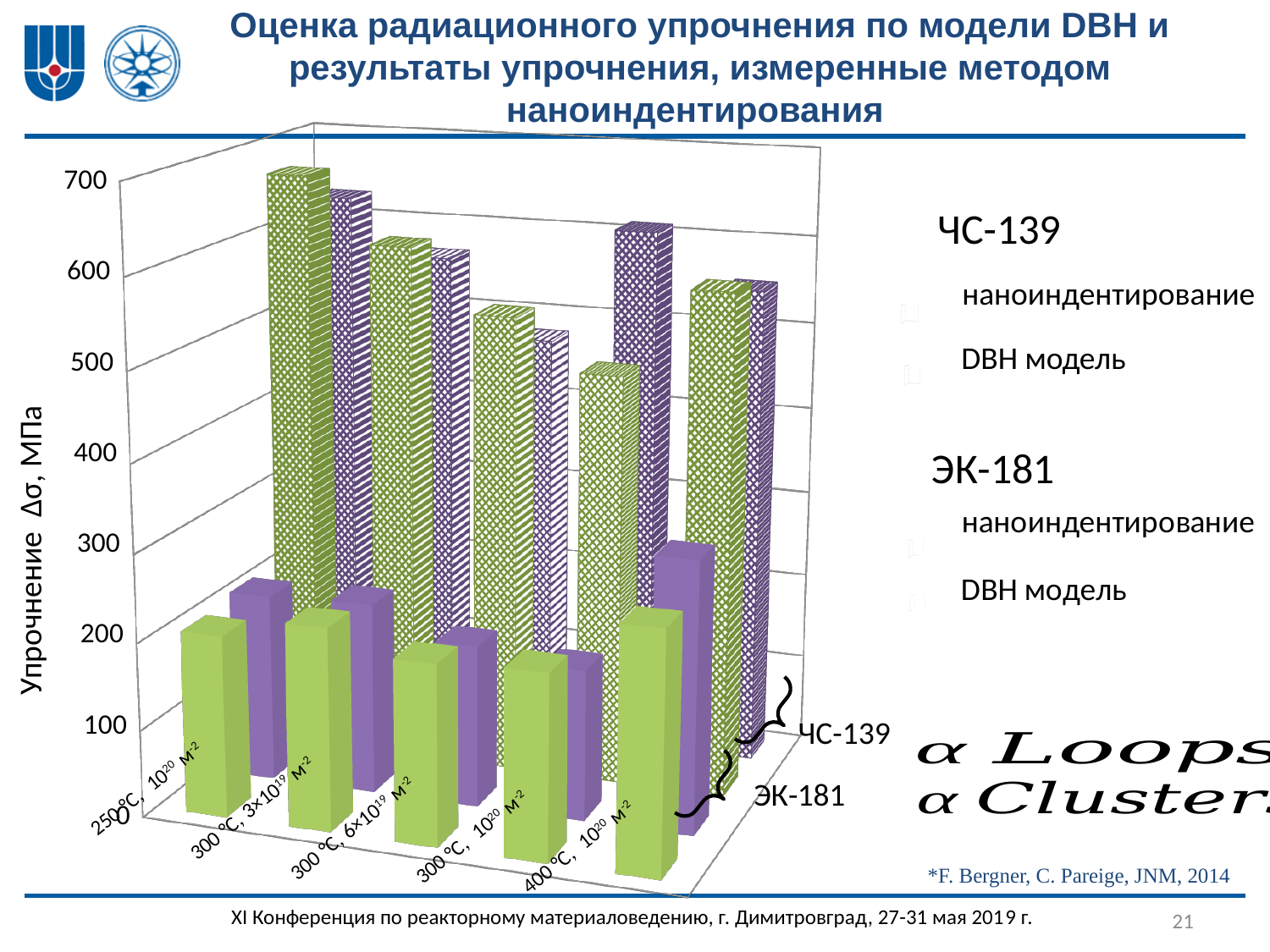
What kind of chart is shown on the slide? 3D bar chart How many irradiation conditions (categories) are shown along the x axis of the chart? 5 Is the ЧС-139 наноиндентирование value at 300 °C, 3×10¹⁹ м⁻² greater or less than 500? greater For which irradiation condition is the ЧС-139 наноиндентирование value lowest? 300 °C, 6×10¹⁹ м⁻² What is the label of the vertical axis of the chart? Упрочнение Δσ, МПа How many series does the chart legend list? 4 At 300 °C, 3×10¹⁹ м⁻², which is larger: the ЧС-139 наноиндентирование value or the ЭК-181 наноиндентирование value? ЧС-139 наноиндентирование Is the ЭК-181 наноиндентирование value at 300 °C, 10²⁰ м⁻² greater or less than 500? less For which irradiation condition is the ЧС-139 наноиндентирование value highest? 250 °C, 10²⁰ м⁻² At 400 °C, 10²⁰ м⁻², which is larger: the ЧС-139 DBH модель value or the ЭК-181 DBH модель value? ЧС-139 DBH модель Which material's bars are plotted in the back row of the chart, ЧС-139 or ЭК-181? ЧС-139